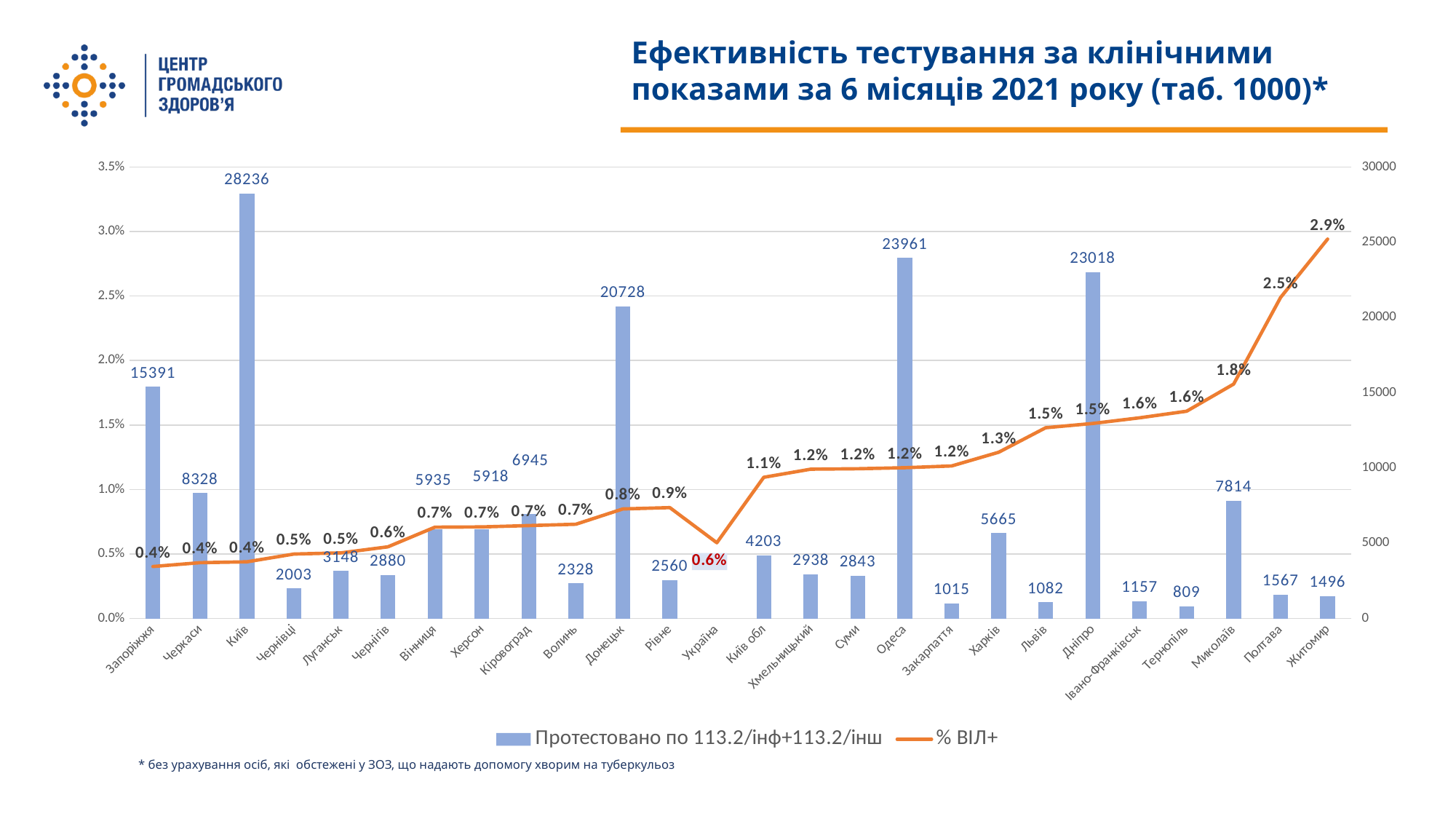
What kind of chart is shown on the slide? A bar chart combined with a line chart How many people were tested (Протестовано) in Київ according to the bar label? 28236 Which has a larger tested count, Донецьк or Одеса? Одеса What is the difference between the tested counts for Одеса and Дніпро? 943 Does the % ВІЛ+ line generally rise or fall from left to right along the x axis? Rises Which region has the lowest number of tested people (shortest bar)? Тернопіль What is the % ВІЛ+ value shown for Житомир? 2.9% What is the difference between the tested counts for Київ and Запоріжжя? 12845 Which region has the highest number of tested people (tallest bar)? Київ What is the % ВІЛ+ value shown for Україна? 0.6% How many series does the legend list? 2 Which region has the highest % ВІЛ+ value on the line? Житомир